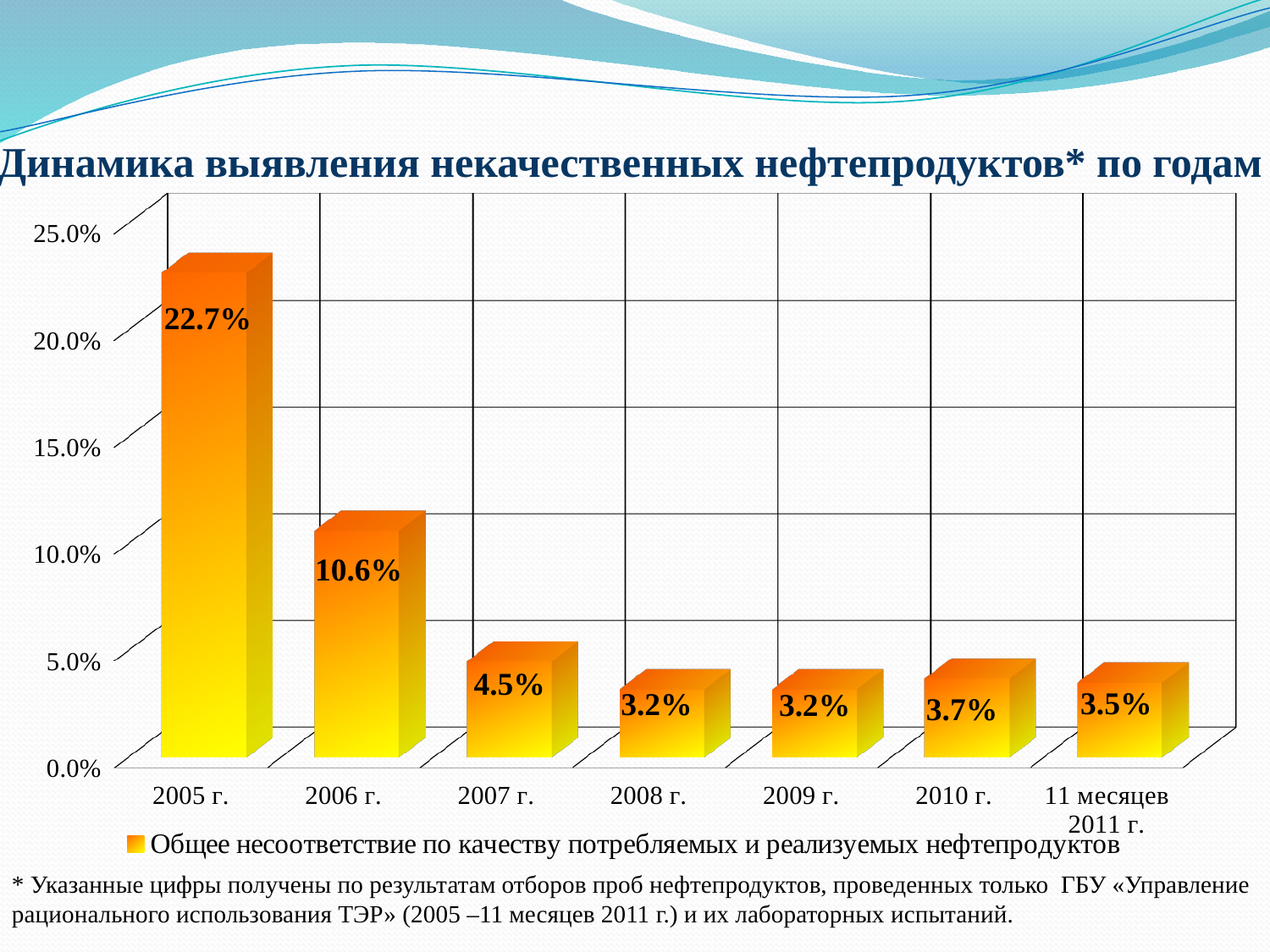
What is the value for 2007 г.? 4.5% How many series does the legend list? 1 Which is larger, the value for 2007 г. or the value for 2010 г.? 2007 г. What is the value for 11 месяцев 2011 г.? 3.5% Which year has the highest value? 2005 г. How many categories are shown on the x axis? 7 What is the difference between the values for 2005 г. and 2006 г.? 12.1% What kind of chart is shown? bar chart Do the values generally rise or fall from 2005 г. to 2008 г.? fall What is the difference between the values for 2010 г. and 2009 г.? 0.5% Is the value for 2006 г. greater or less than 10.0%? greater What is the value for 2005 г.? 22.7%